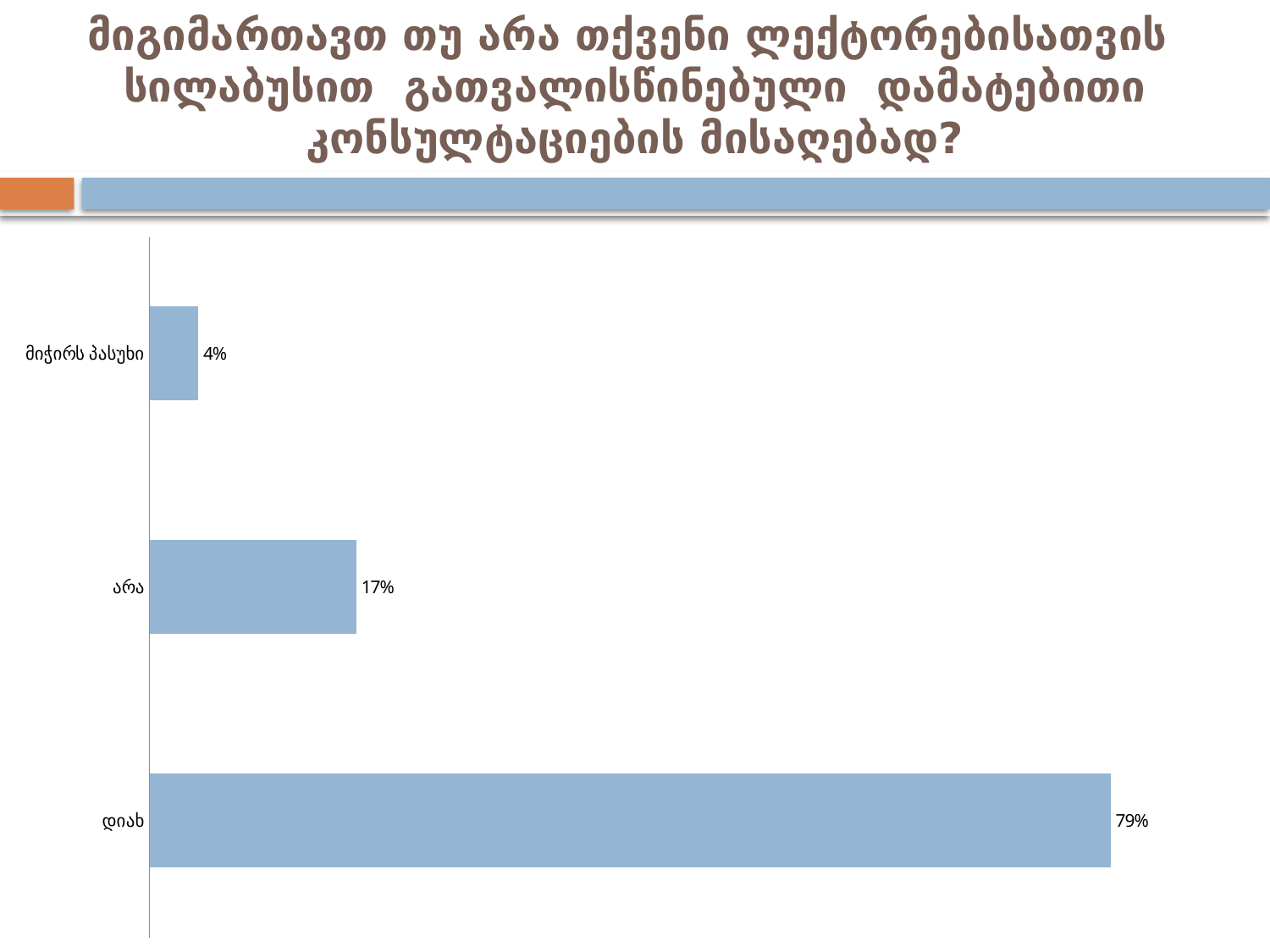
What is the value for "დიახ"? 79% What is the total of the three values shown in the chart? 100% What is the difference between the values for "დიახ" and "არა"? 62% Which is larger, the value for "არა" or the value for "მიჭირს პასუხი"? არა Which category has the lowest value? მიჭირს პასუხი How many categories are shown in the chart? 3 What is the value for "არა"? 17% What colour are the bars in the chart? light blue Which category has the highest value? დიახ What kind of chart is shown on the slide? bar chart What is the difference between the values for "არა" and "მიჭირს პასუხი"? 13% What is the value for "მიჭირს პასუხი"? 4%